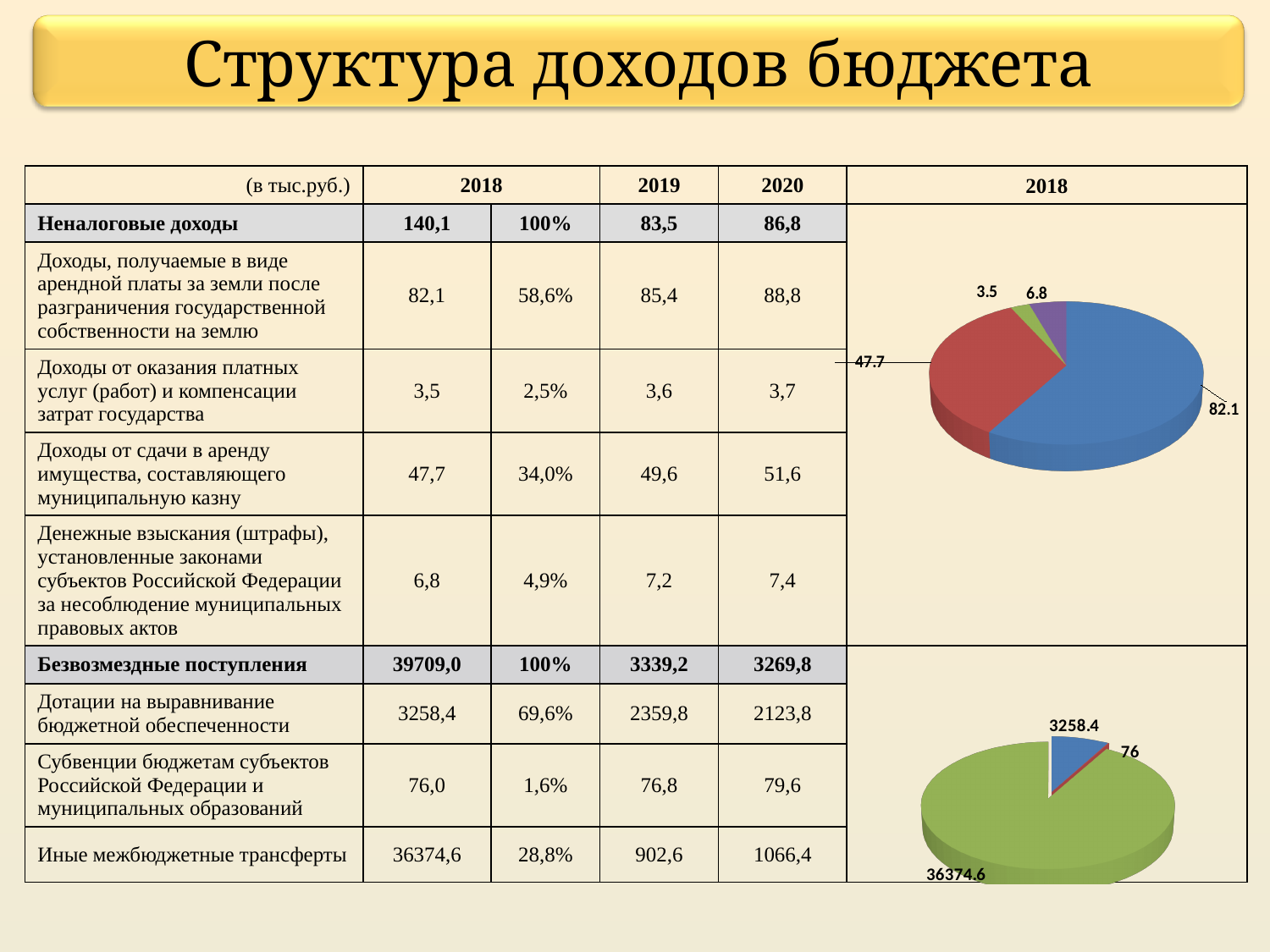
In the upper pie chart, which slice is larger: the one labelled 6.8 or the one labelled 3.5? 6.8 In the upper pie chart, what is the value of the smallest slice? 3.5 In the lower pie chart, what is the difference between the green slice (36374.6) and the blue slice (3258.4)? 33116.2 In the upper pie chart, what is the value of the largest slice? 82.1 How many slices does the lower pie chart have? 3 In the lower pie chart, what is the value of the smallest slice? 76 In the lower pie chart, what is the value of the largest (green) slice? 36374.6 In the upper pie chart, what share of the total do the four slices give to the slice labelled 82.1? 58.6% How many slices does the upper pie chart (labelled 2018) have? 4 What type of chart is the upper chart on the right side of the slide? pie chart In the upper pie chart, what is the difference between the blue slice (82.1) and the red slice (47.7)? 34.4 In the upper pie chart, what is the value shown for the red slice? 47.7